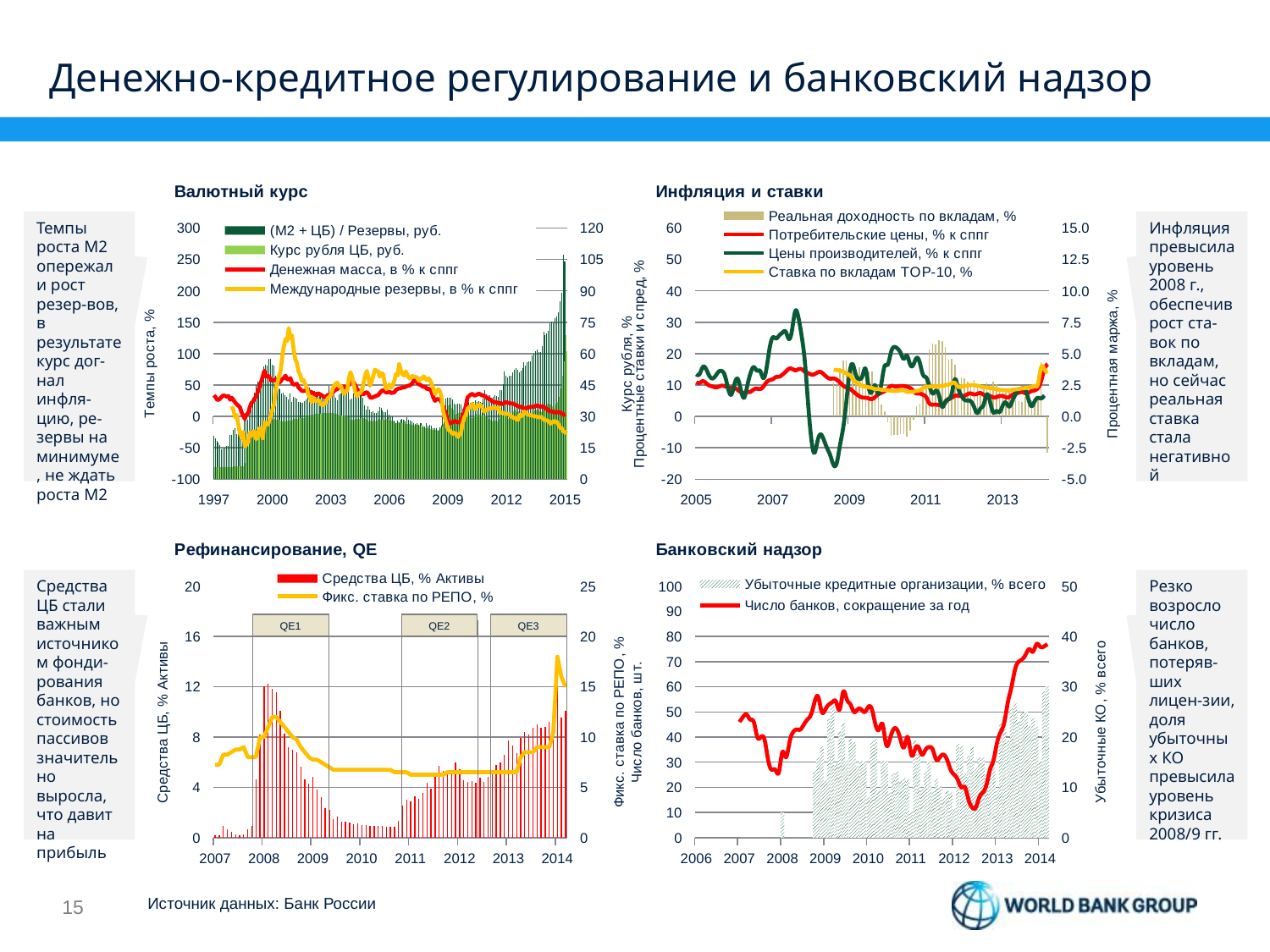
On the 'Банковский надзор' chart, does 'Число банков, сокращение за год' rise or fall between 2012 and 2014? rise On the 'Рефинансирование, QE' chart, is the peak of 'Средства ЦБ, % Активы' in 2008–2009 greater or less than 8 on the left axis? greater On the 'Рефинансирование, QE' chart, how many QE periods are labelled? 3 On the 'Инфляция и ставки' chart, is the peak of 'Цены производителей, % к сппг' around 2008 greater or less than 20 on the left axis? greater What data source is cited at the bottom of the slide? Банк России On the 'Банковский надзор' chart, is the peak value of 'Число банков, сокращение за год' near 2014 greater or less than 60 on the left axis? greater On the 'Инфляция и ставки' chart, how many series does the legend list? 4 On the 'Рефинансирование, QE' chart, what kind of chart is used to plot 'Средства ЦБ, % Активы'? bar chart On the 'Рефинансирование, QE' chart, how many series does the legend list? 2 On the 'Валютный курс' chart, how many series does the legend list? 4